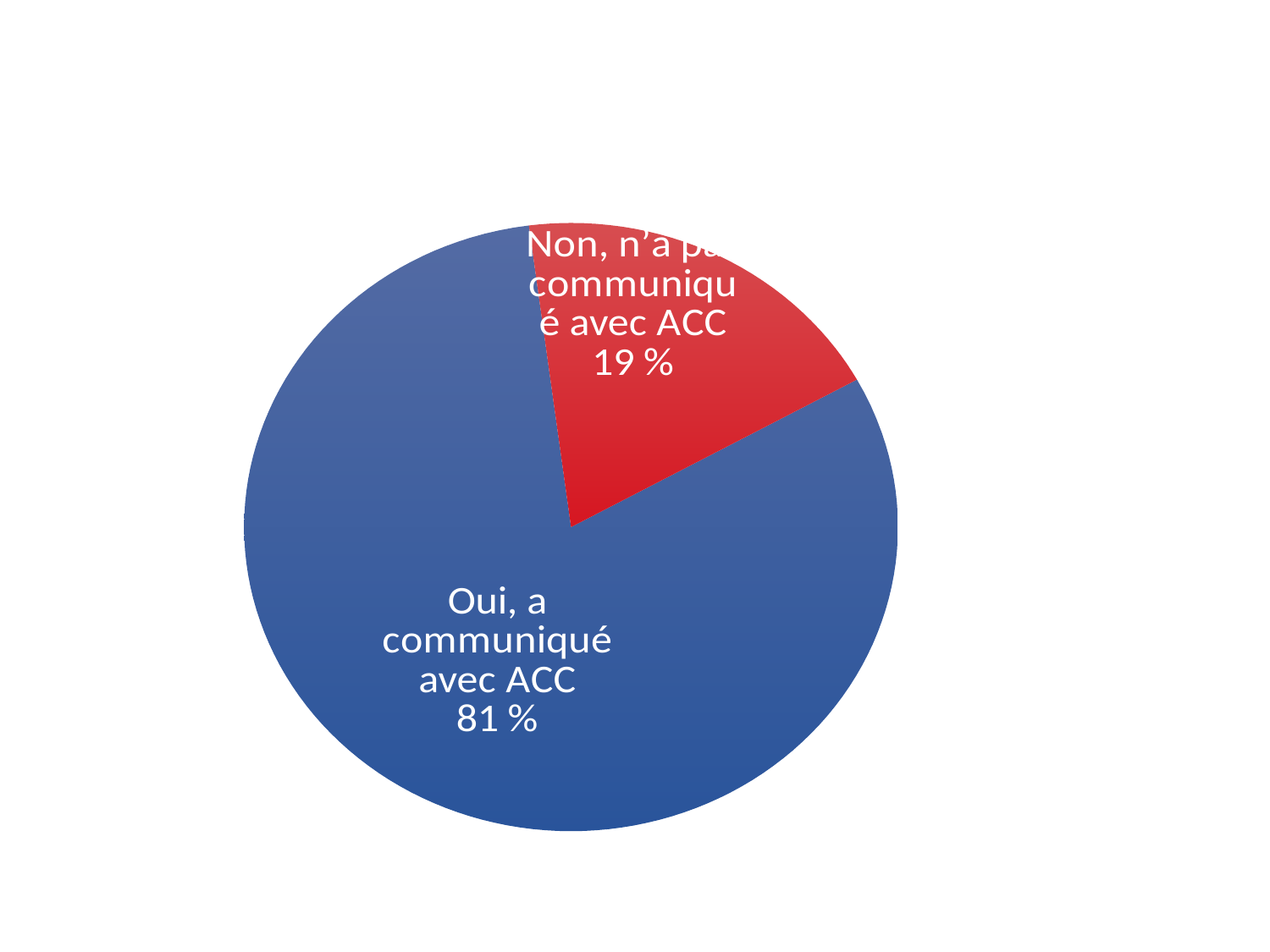
What colour is the slice for "Oui, a communiqué avec ACC"? blue Which slice of the pie is the smallest? Non, n'a pas communiqué avec ACC Which slice of the pie is the largest? Oui, a communiqué avec ACC What is the difference in percentage points between the "Oui" slice and the "Non" slice? 62 How many slices does the pie chart have? 2 What share of the pie is labelled "Non, n'a pas communiqué avec ACC"? 19 % Is the share for "Oui, a communiqué avec ACC" greater or less than 50 %? greater What colour is the slice for "Non, n'a pas communiqué avec ACC"? red Which is larger: the share for "Oui, a communiqué avec ACC" or the share for "Non, n'a pas communiqué avec ACC"? Oui, a communiqué avec ACC What share of the pie is labelled "Oui, a communiqué avec ACC"? 81 % What kind of chart is shown on the slide? pie chart